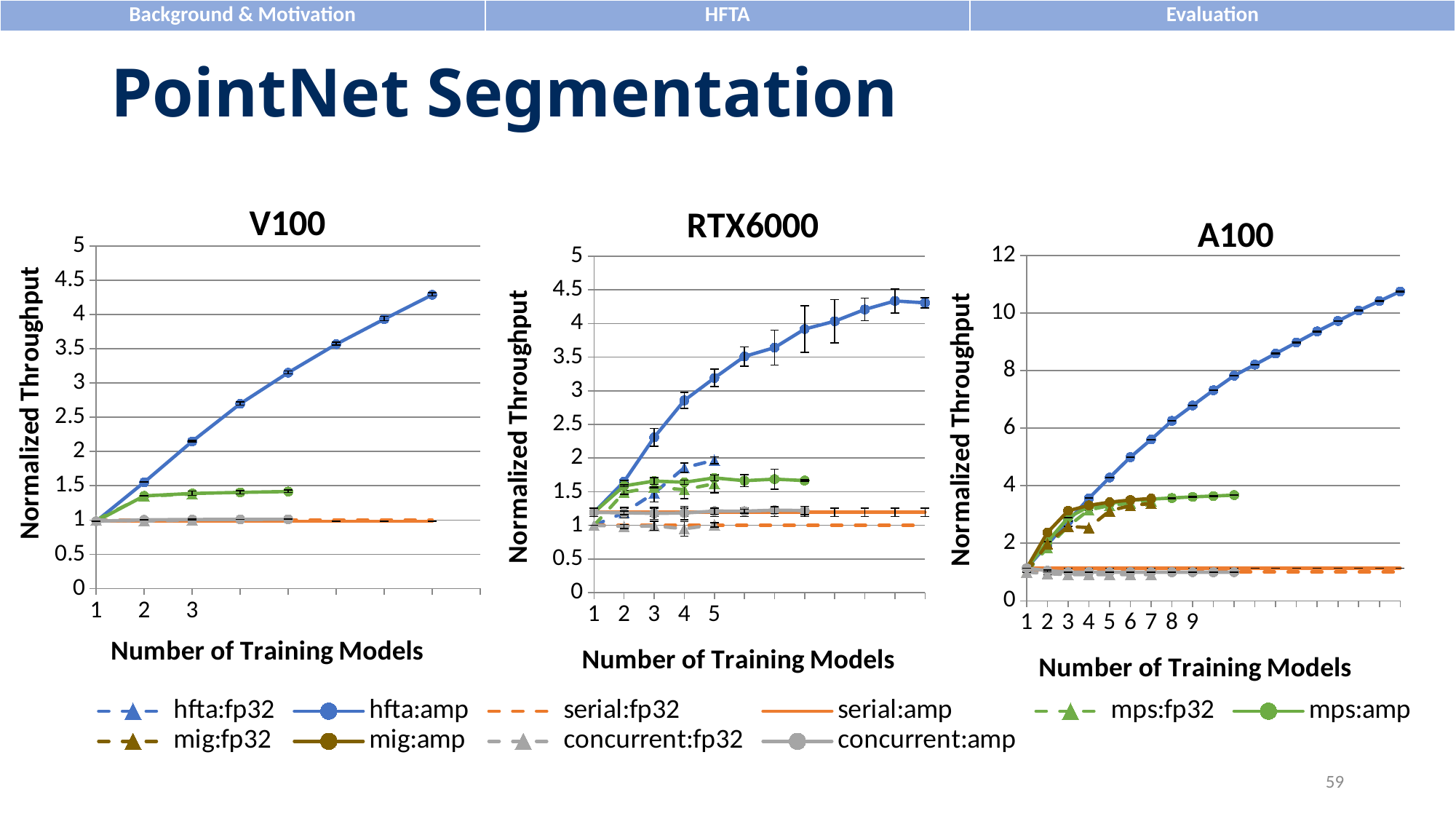
What is the y-axis label of the RTX6000 chart? Normalized Throughput In the A100 chart, which series reaches the highest normalized throughput? hfta:amp In the A100 chart, is the value of serial:amp at 9 training models greater or less than 2? less In the RTX6000 chart, is the value of hfta:amp at 2 training models greater or less than 2? less What kind of chart is the V100 chart? line chart In the V100 chart, does the hfta:amp series rise or fall as the number of training models increases? rise How many charts are shown on the slide? 3 How many series does the shared legend list? 10 In the V100 chart, is the value of hfta:amp at the rightmost point greater or less than 4? greater In the V100 chart, which is larger at 3 training models, hfta:amp or mps:amp? hfta:amp What is the maximum value shown on the y-axis of the A100 chart? 12